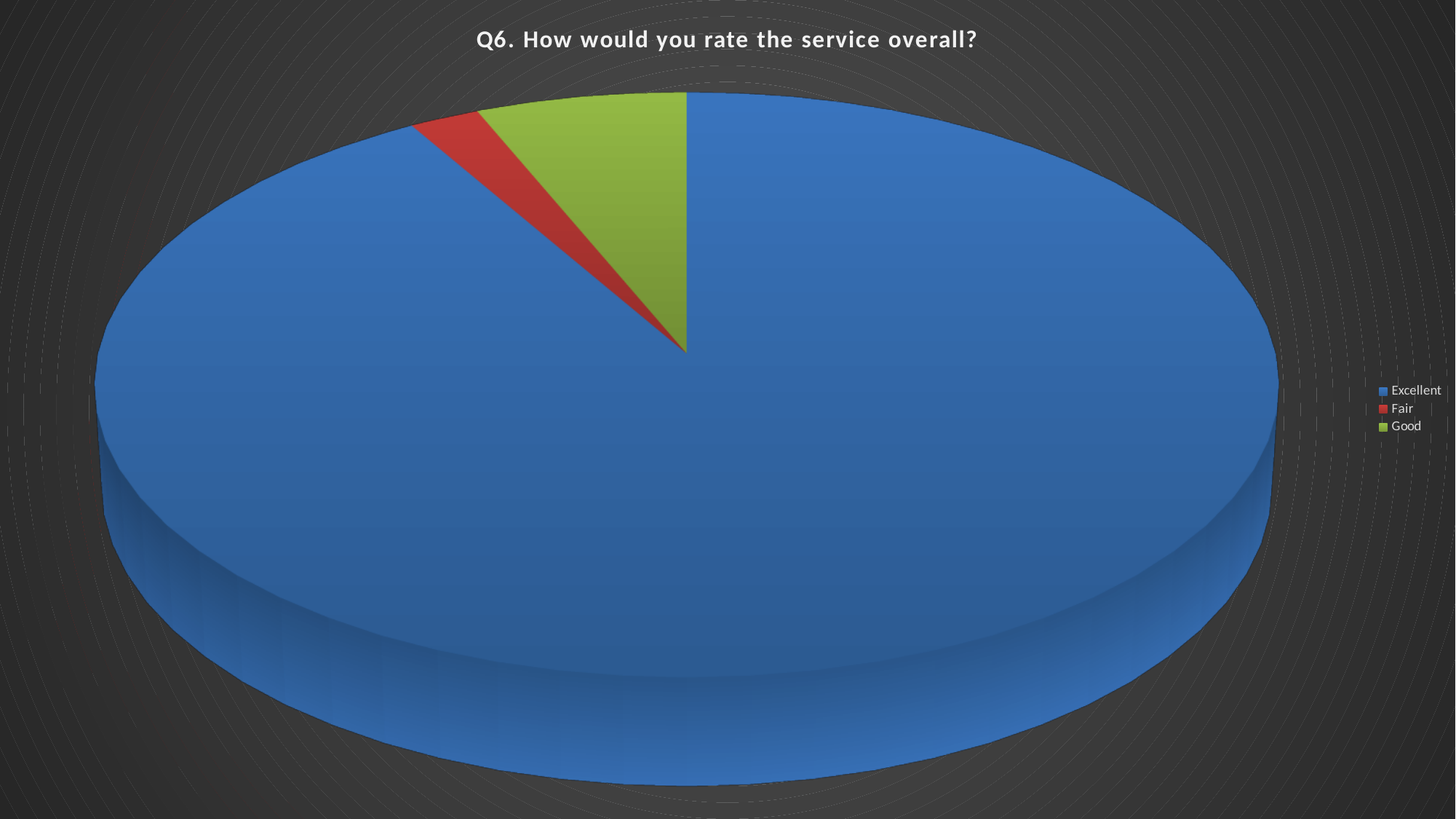
What is the title of the chart? Q6. How would you rate the service overall? Does the Excellent slice make up more or less than half of the pie? more Which slice is larger, Excellent or Good? Excellent Which category has the largest slice of the pie? Excellent What kind of chart is shown on the slide? pie chart How many categories does the legend list? 3 Which slice is larger, Good or Fair? Good Which colour represents the Fair category? red Which category has the smallest slice of the pie? Fair